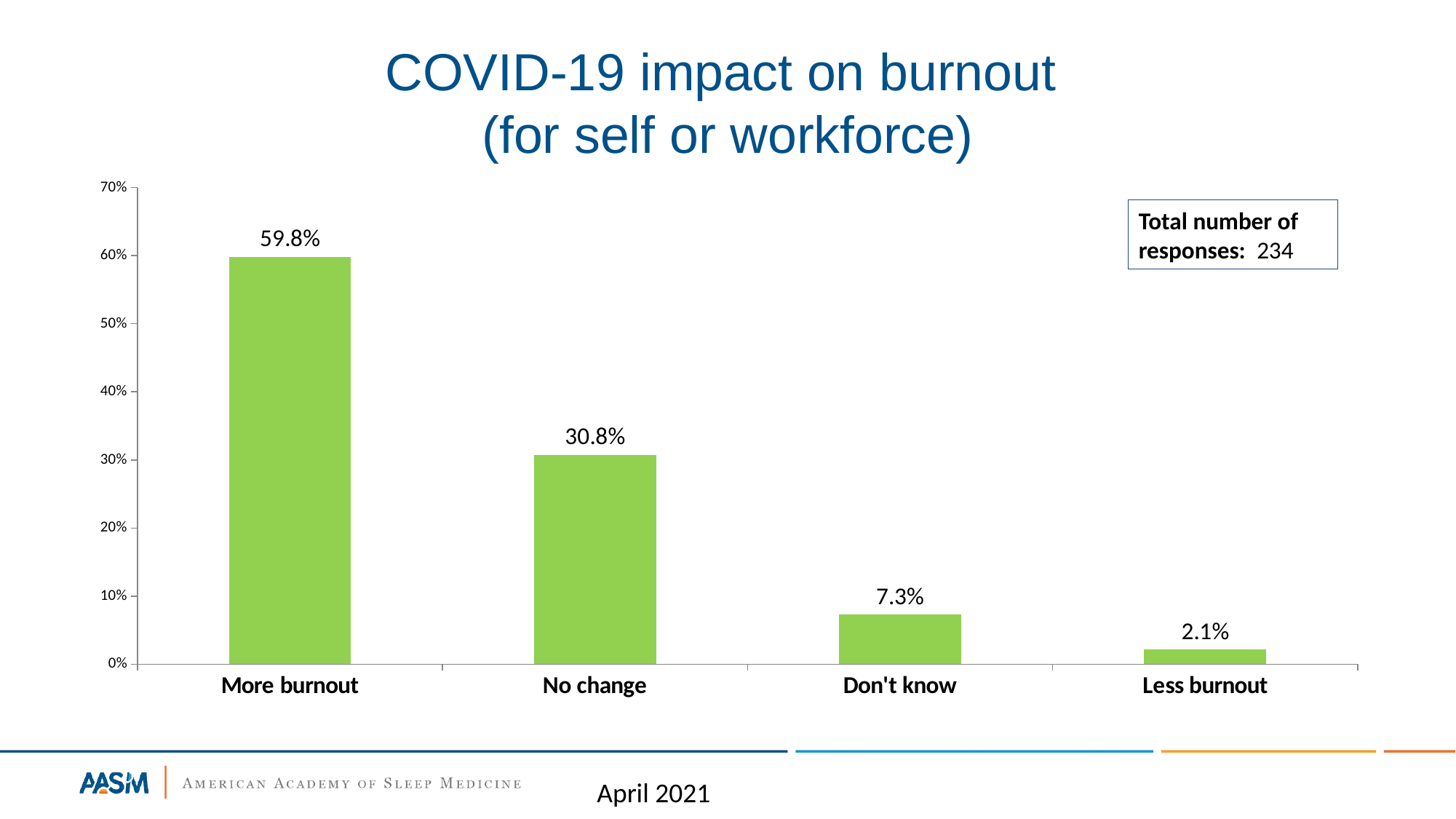
What percentage of respondents reported more burnout? 59.8% What is the value for 'Less burnout'? 2.1% Which category has the lowest value? Less burnout What is the total number of responses stated on the slide? 234 How many categories are shown on the x axis? 4 Is the value for 'No change' greater or less than 40%? less Which is larger, the value for 'Don't know' or the value for 'Less burnout'? Don't know What is the difference in percentage points between 'More burnout' and 'No change'? 29.0% What percentage of respondents answered 'Don't know'? 7.3% What kind of chart is shown on the slide? bar chart Which category has the highest value? More burnout What is the value for the 'No change' category? 30.8%